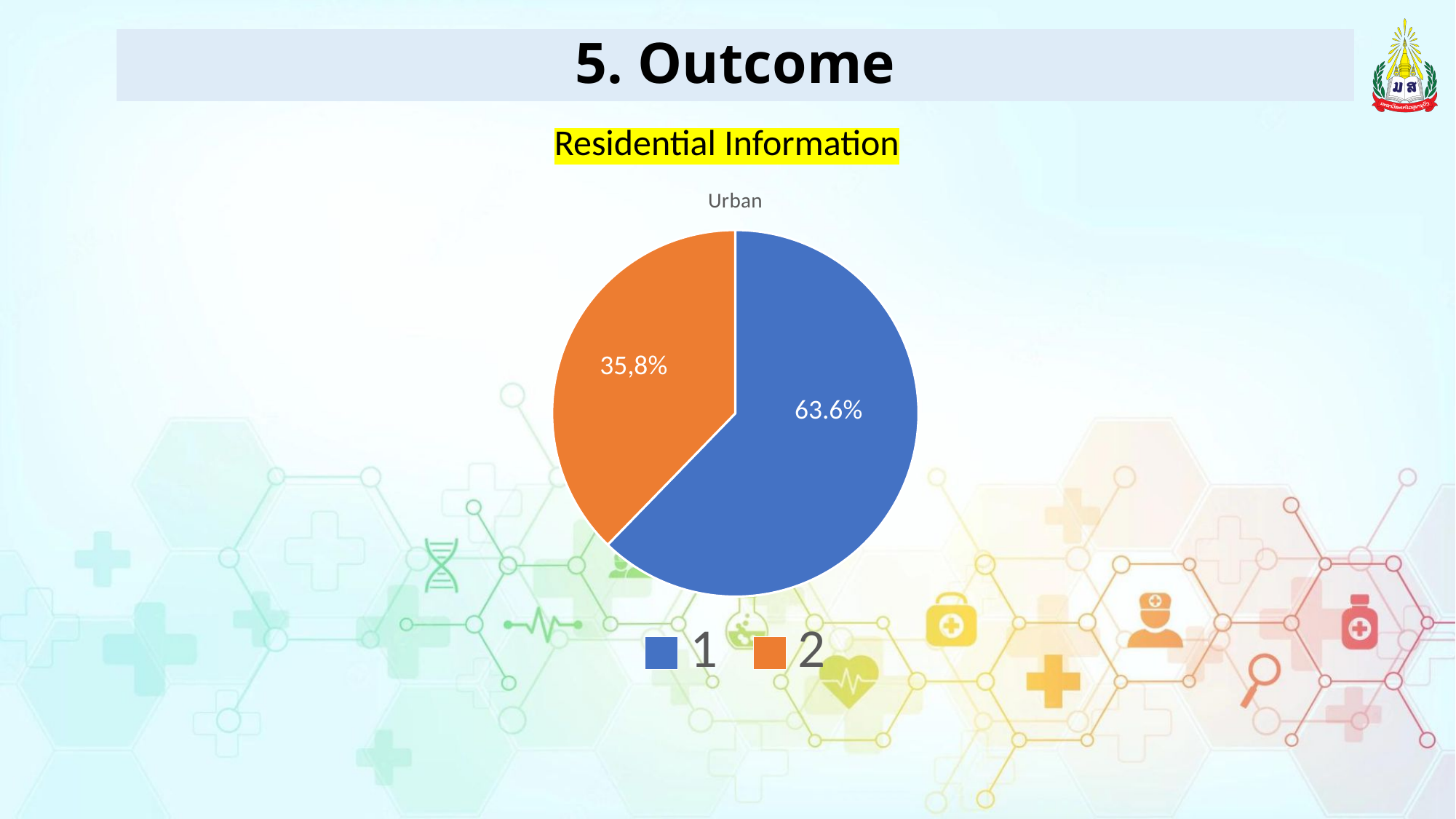
What colour is slice 1 in the pie chart? blue Which is larger in the pie chart, slice 1 or slice 2? 1 Which slice of the pie chart is the smallest? 2 What share of the pie does slice 2 represent? 35,8% What percentage is shown for slice 1 in the pie chart? 63.6% What percentage is shown for slice 2 in the pie chart? 35,8% What kind of chart is shown on the slide? pie chart What is the title of the chart? Urban How many slices does the pie chart have? 2 Which slice of the pie chart is the largest? 1 How many entries does the legend of the pie chart list? 2